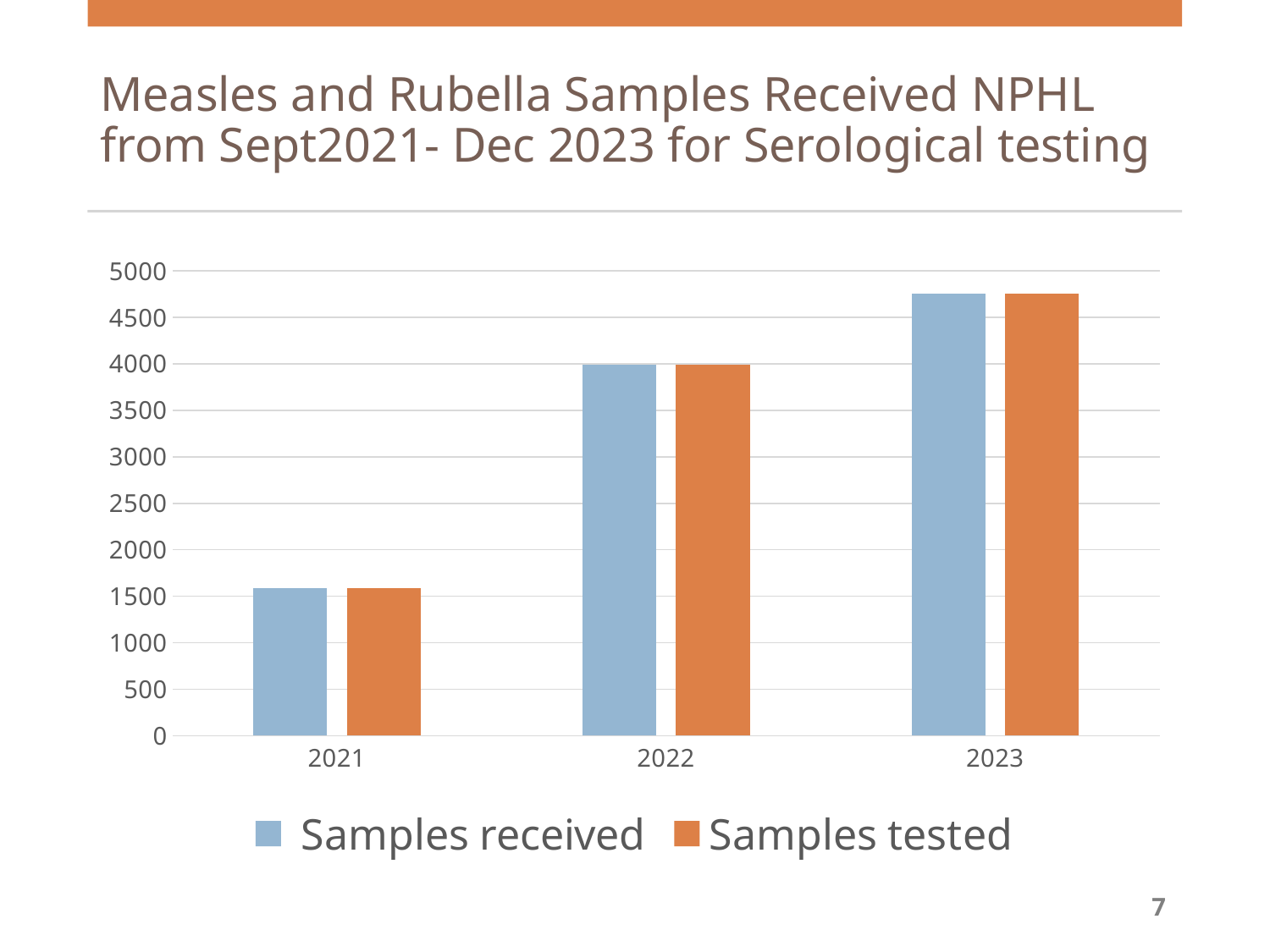
What kind of chart is shown on the slide? bar chart Which colour represents the Samples tested series? orange How many years are shown on the x axis? 3 Is the value for samples received in 2021 greater or less than 2000? less How many series does the legend list? 2 Is the value for samples tested in 2022 greater or less than 3500? greater Do the samples received values rise or fall from 2021 to 2023? rise Which is larger: samples received in 2022 or samples received in 2021? 2022 Which year has the highest number of samples received? 2023 Is the value for samples received in 2023 greater or less than 4500? greater Which year has the lowest number of samples tested? 2021